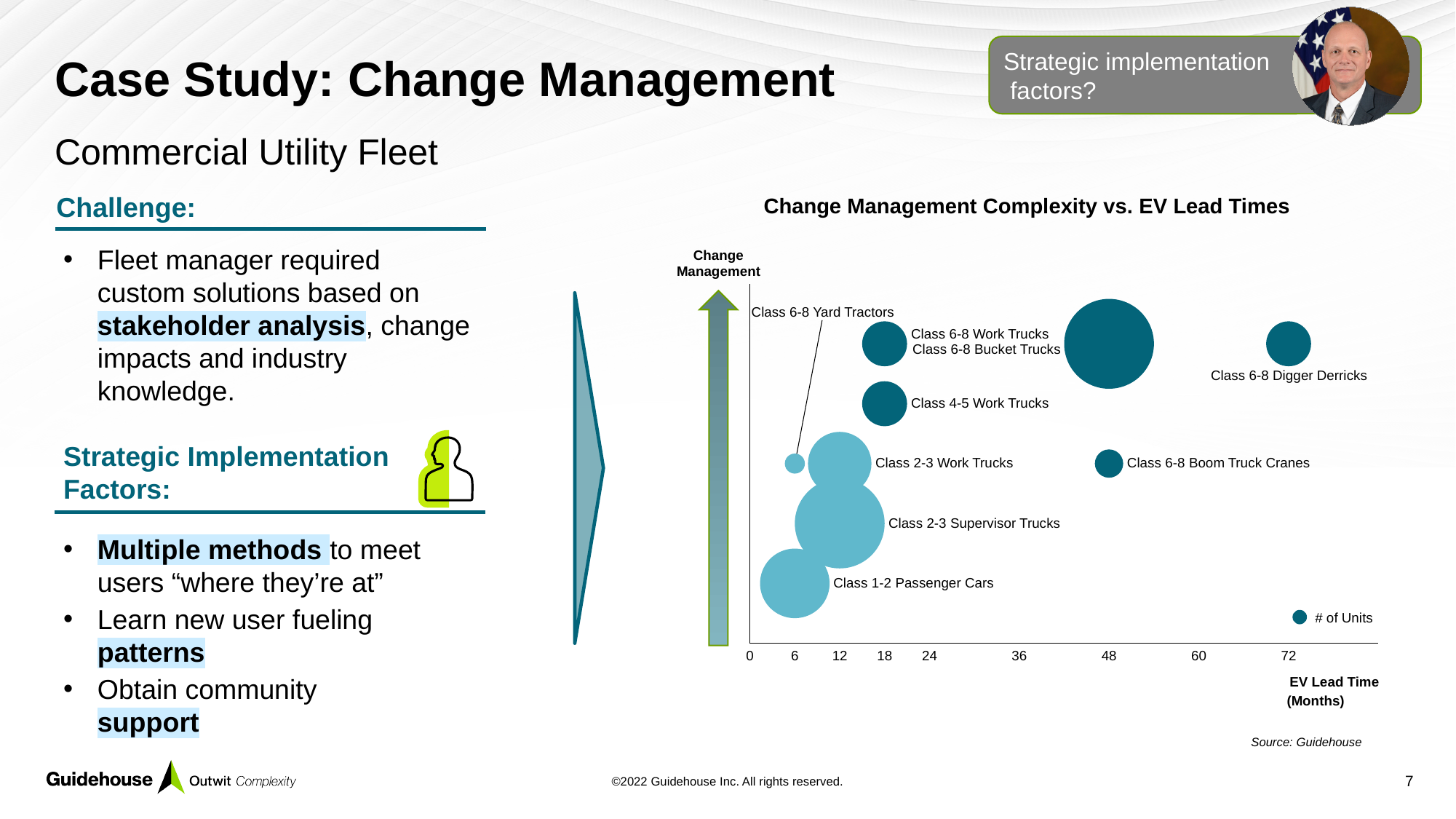
Is the EV lead time for Class 6-8 Digger Derricks greater or less than 60 months? greater Which vehicle class is plotted lowest on the Change Management axis? Class 1-2 Passenger Cars What is the title of the chart? Change Management Complexity vs. EV Lead Times How many bubbles (vehicle classes) are plotted on the chart? 9 Is the EV lead time for Class 6-8 Boom Truck Cranes greater or less than 36 months? greater Is the EV lead time for Class 1-2 Passenger Cars greater or less than 12 months? less Which has the longer EV lead time, Class 6-8 Digger Derricks or Class 2-3 Supervisor Trucks? Class 6-8 Digger Derricks What does the bubble size represent according to the legend? # of Units How many series does the chart legend list? 1 Which vehicle class has the largest bubble (most units)? Class 6-8 Bucket Trucks What kind of chart is shown on the slide? Bubble chart Which vehicle class has the smallest bubble (fewest units)? Class 6-8 Yard Tractors